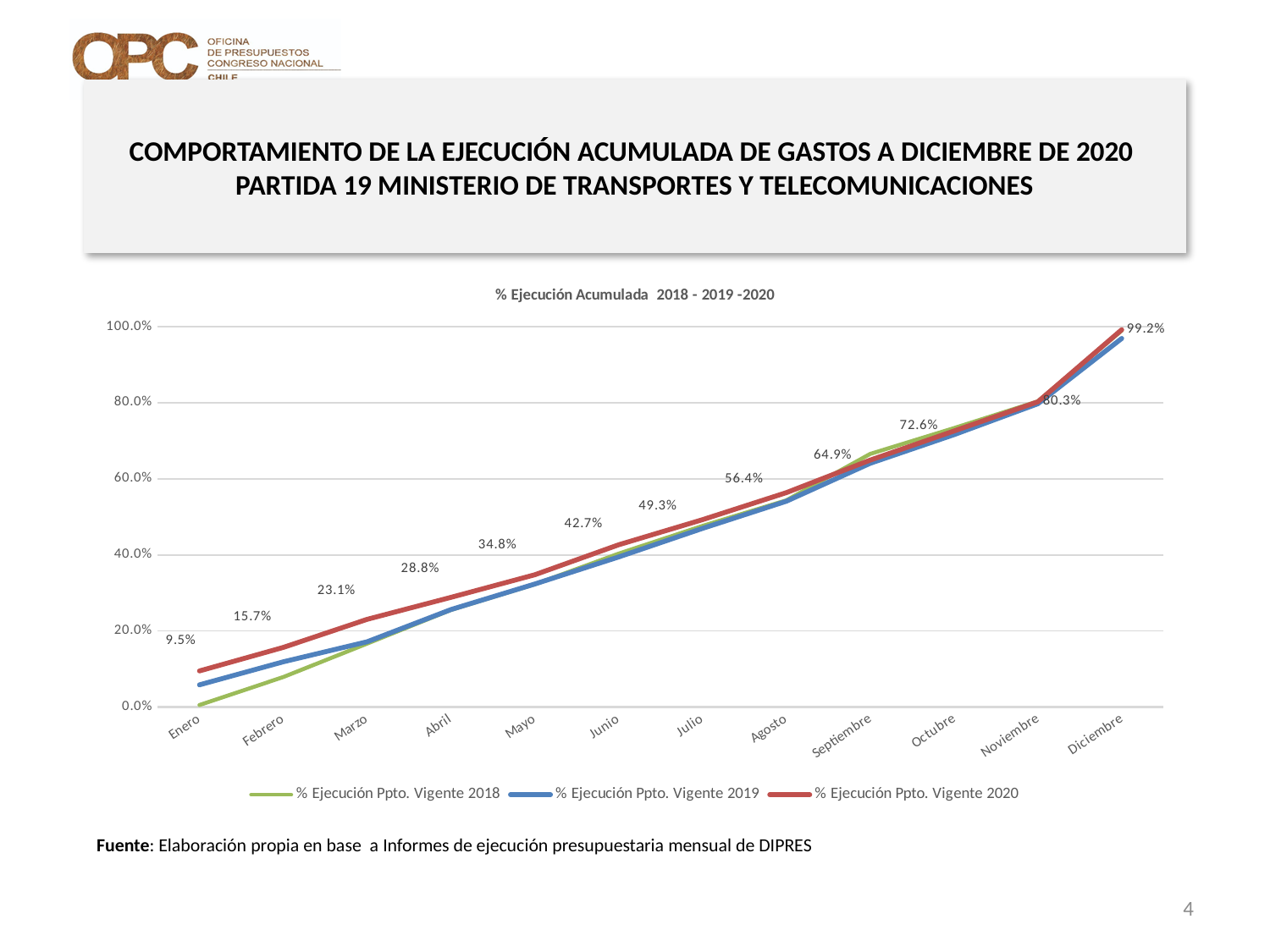
How many series does the legend list? 3 In which month is the value for % Ejecución Ppto. Vigente 2020 highest? Diciembre What is the difference between the % Ejecución Ppto. Vigente 2020 values for Diciembre and Noviembre? 18.9% Do the values for % Ejecución Ppto. Vigente 2020 rise or fall from Enero to Diciembre? rise What kind of chart is shown on the slide? line chart Is the value for % Ejecución Ppto. Vigente 2018 in Enero greater or less than 20.0%? less In which month is the value for % Ejecución Ppto. Vigente 2020 lowest? Enero What is the value for % Ejecución Ppto. Vigente 2020 in Junio? 42.7% How many months are shown along the x axis? 12 What is the value for % Ejecución Ppto. Vigente 2020 in Enero? 9.5% What is the value for % Ejecución Ppto. Vigente 2020 in Septiembre? 64.9% What is the value for % Ejecución Ppto. Vigente 2020 in Diciembre? 99.2%